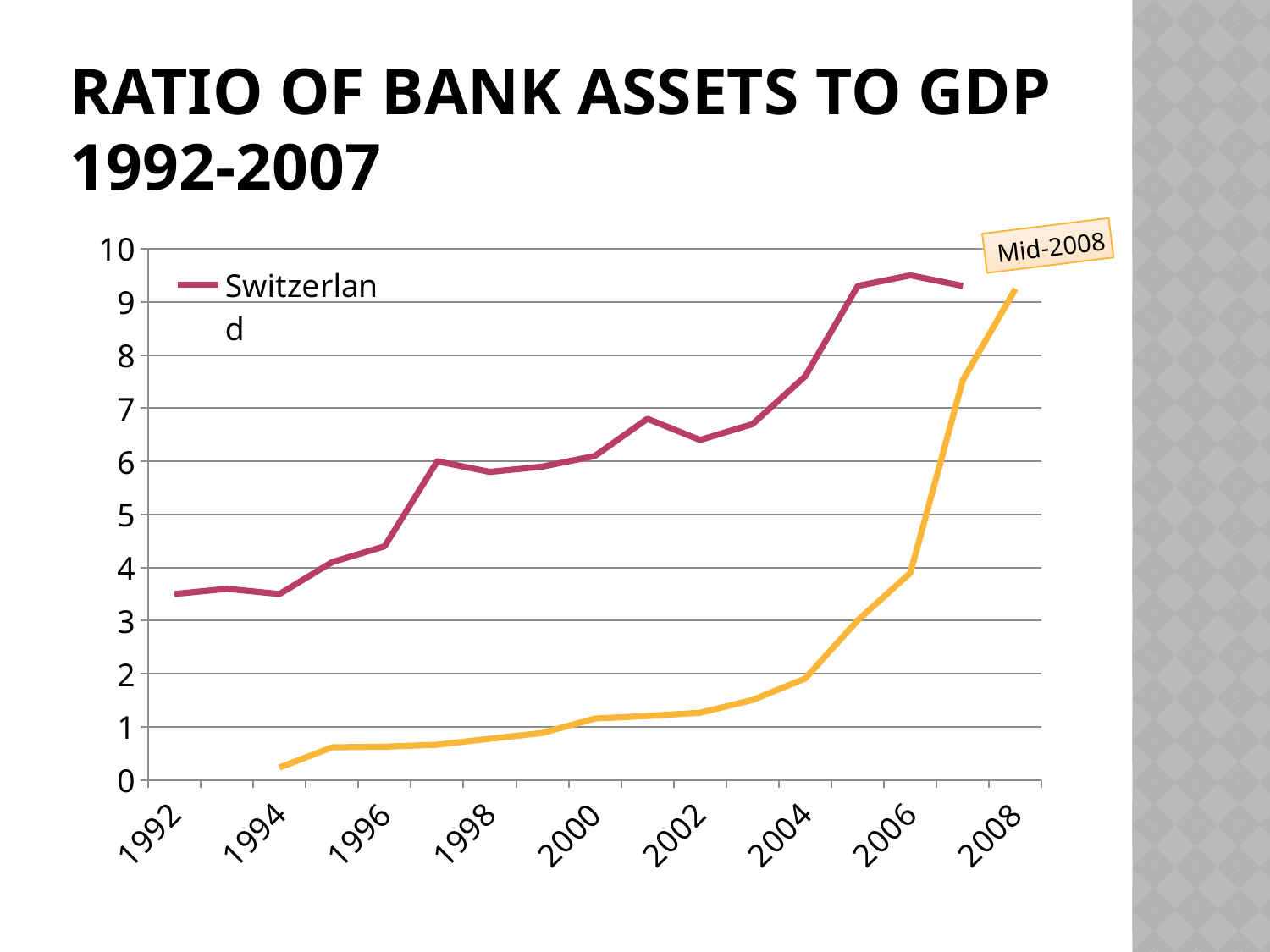
Does the Switzerland line generally rise or fall from 1992 to 2007? rise How many series does the legend list? 1 Which series is named in the legend? Switzerland What kind of chart is shown on the slide? line chart What is the title of the chart on the slide? RATIO OF BANK ASSETS TO GDP 1992-2007 Is the value for Switzerland in 2004 greater or less than 7? greater In 2004, which line is higher, the Switzerland line or the orange line? Switzerland Is the value for Switzerland in 2006 greater or less than 9? greater Which is larger for Switzerland, the value in 1992 or the value in 2006? 2006 Is the value for Switzerland in 1996 greater or less than 5? less